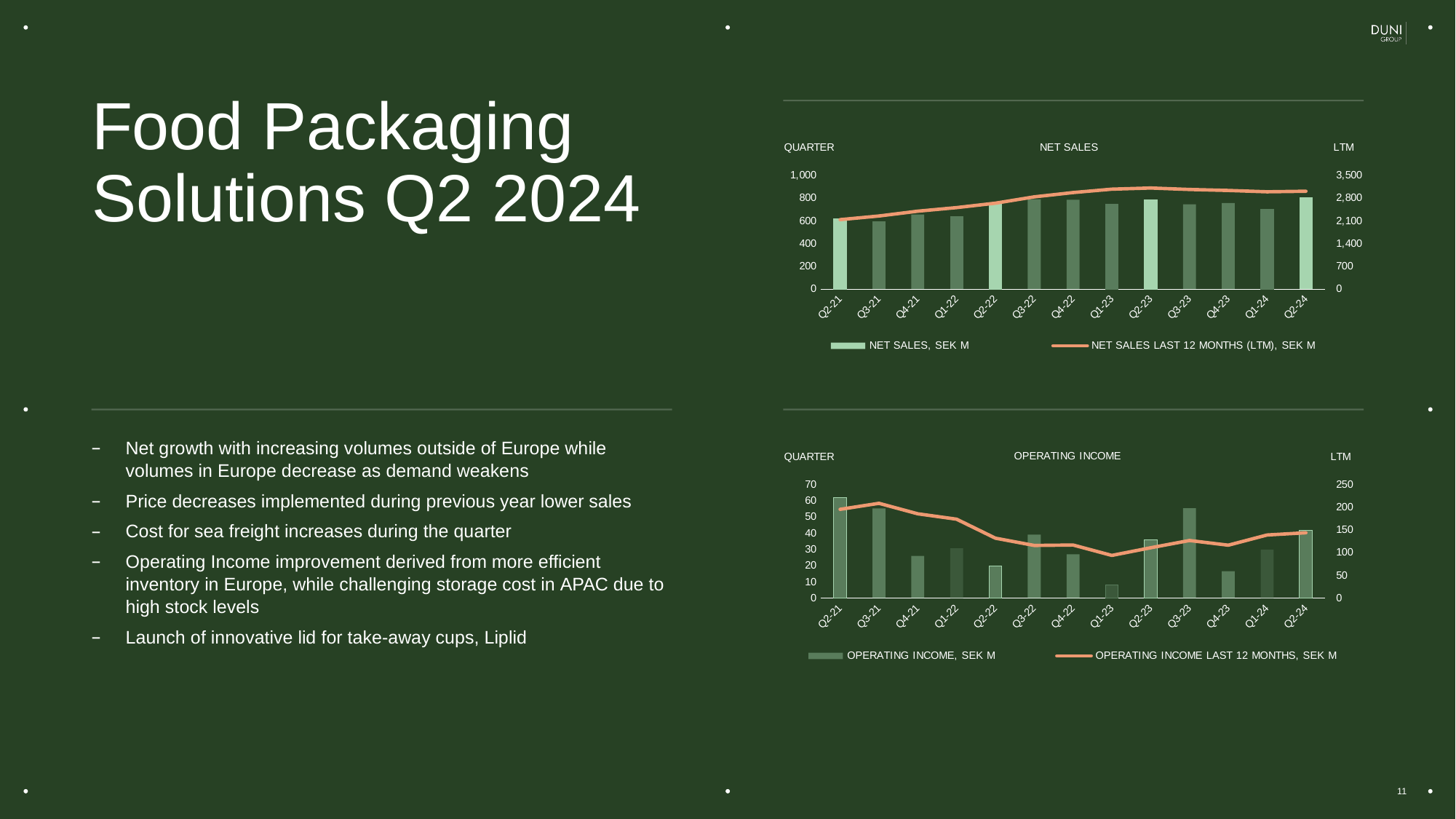
What kind of chart is the OPERATING INCOME chart? Combined bar and line chart On the NET SALES chart, is the net sales bar for Q4-21 greater or less than 800? less On the NET SALES chart, is the net sales bar for Q1-24 greater or less than 600? greater On the OPERATING INCOME chart, is the operating income bar for Q3-22 larger or smaller than the bar for Q2-22? larger On the OPERATING INCOME chart, which quarter has the lowest operating income bar? Q1-23 On the NET SALES chart, what is the label of the line series in the legend? NET SALES LAST 12 MONTHS (LTM), SEK M On the OPERATING INCOME chart, is the operating income for Q2-21 greater or less than 50? greater On the OPERATING INCOME chart, does the operating income last 12 months line rise or fall from Q3-21 to Q1-23? fall On the OPERATING INCOME chart, which quarter has the highest operating income bar? Q2-21 On the NET SALES chart, how many quarters are shown on the x axis? 13 On the NET SALES chart, how many series does the legend list? 2